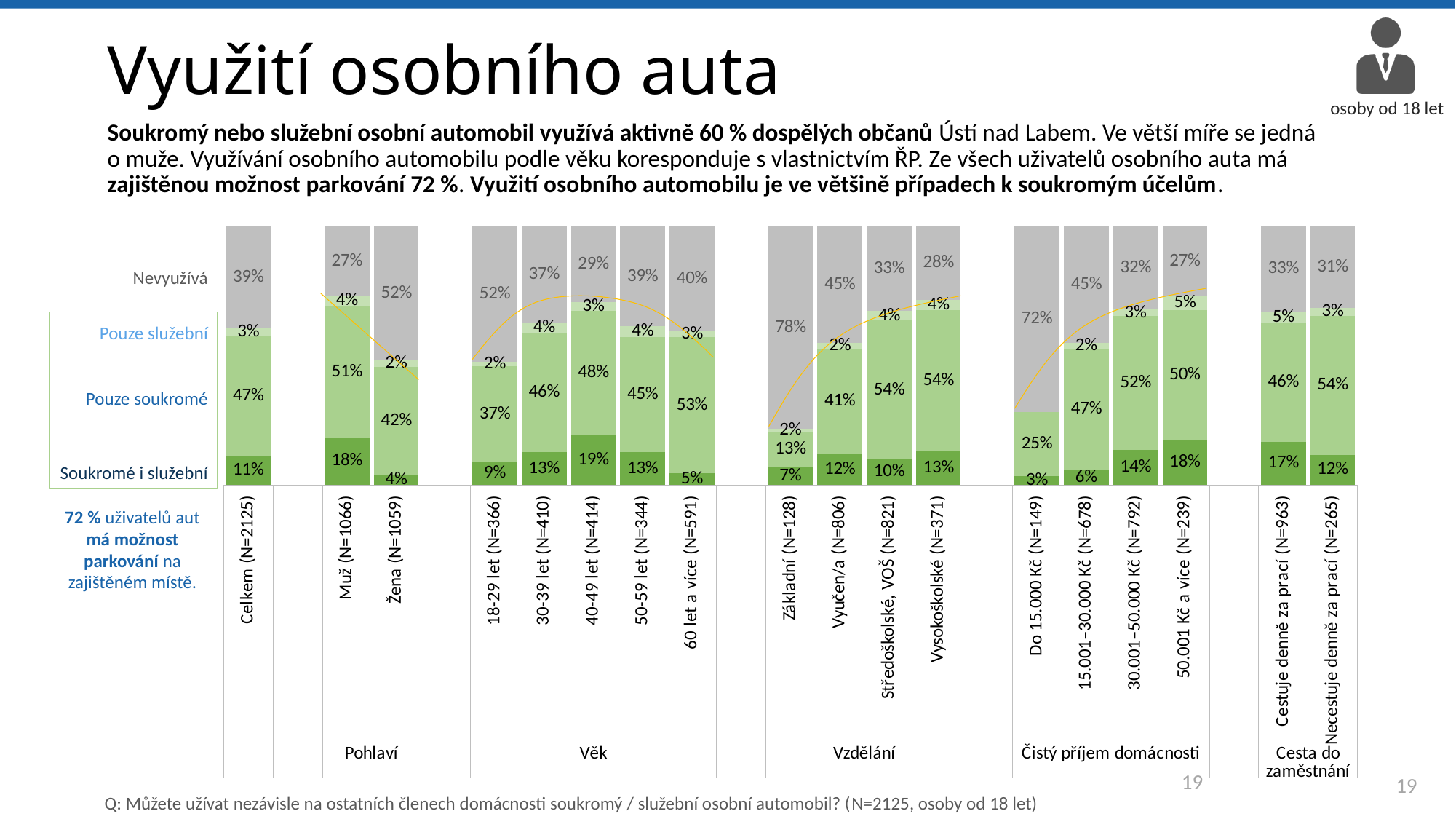
What is the difference in percentage points between the Pouze soukromé values for Muž (N=1066) and Žena (N=1059)? 9 percentage points What type of chart is shown on the slide? Stacked bar chart What is the total of the stacked bar for Celkem (N=2125)? 100% Which has a larger Soukromé i služební share: 50.001 Kč a více (N=239) or 15.001–30.000 Kč (N=678)? 50.001 Kč a více (N=239) What is the Pouze soukromé value for Muž (N=1066)? 51% Which has a larger Nevyužívá share: Cestuje denně za prací (N=963) or Necestuje denně za prací (N=265)? Cestuje denně za prací (N=963) What percentage of the Celkem (N=2125) group falls into the Nevyužívá category? 39% What is the Soukromé i služební value for 40-49 let (N=414)? 19% What is the Nevyužívá value for Základní (N=128)? 78% Among the age groups (Věk), which has the lowest Soukromé i služební share? 60 let a více (N=591) How many series (response categories) are shown in the stacked bars? 4 Which category has the highest Nevyužívá share? Základní (N=128)